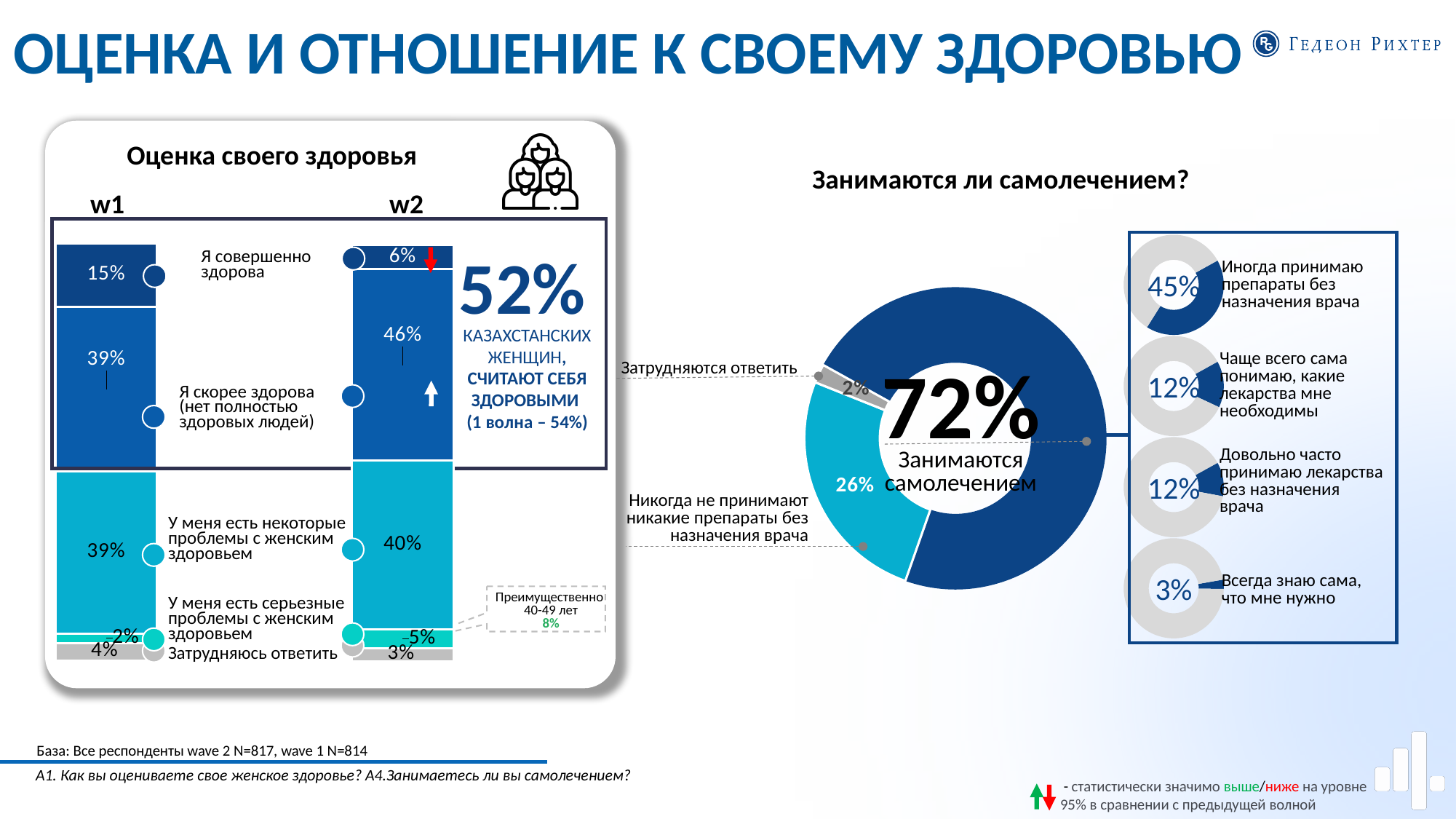
What kind of chart is 'Занимаются ли самолечением?'? Donut (pie) chart In the 'Оценка своего здоровья' chart, what is the w2 value for 'Я скорее здорова (нет полностью здоровых людей)'? 46% In the 'Оценка своего здоровья' chart, what is the w2 value for 'Затрудняюсь ответить'? 3% What kind of chart is 'Оценка своего здоровья'? Stacked bar chart In the 'Занимаются ли самолечением?' chart, which segment is the largest? Занимаются самолечением (72%) In the 'Занимаются ли самолечением?' chart, what share of respondents answered 'Затрудняются ответить'? 2% In the 'Занимаются ли самолечением?' chart, what share of respondents never take medicines without a doctor's prescription ('Никогда не принимают никакие препараты без назначения врача')? 26% In the 'Оценка своего здоровья' chart, which wave has the higher value for 'У меня есть некоторые проблемы с женским здоровьем', w1 or w2? w2 In the 'Оценка своего здоровья' chart, what is the w1 value for 'У меня есть серьезные проблемы с женским здоровьем'? 2% In the 'Оценка своего здоровья' chart, what is the w2 value for 'Я совершенно здорова'? 6% In the 'Оценка своего здоровья' chart, by how many percentage points did 'Я совершенно здорова' change from w1 to w2? 9 percentage points (15% to 6%) In the 'Оценка своего здоровья' chart, what is the w1 value for 'Я совершенно здорова'? 15%